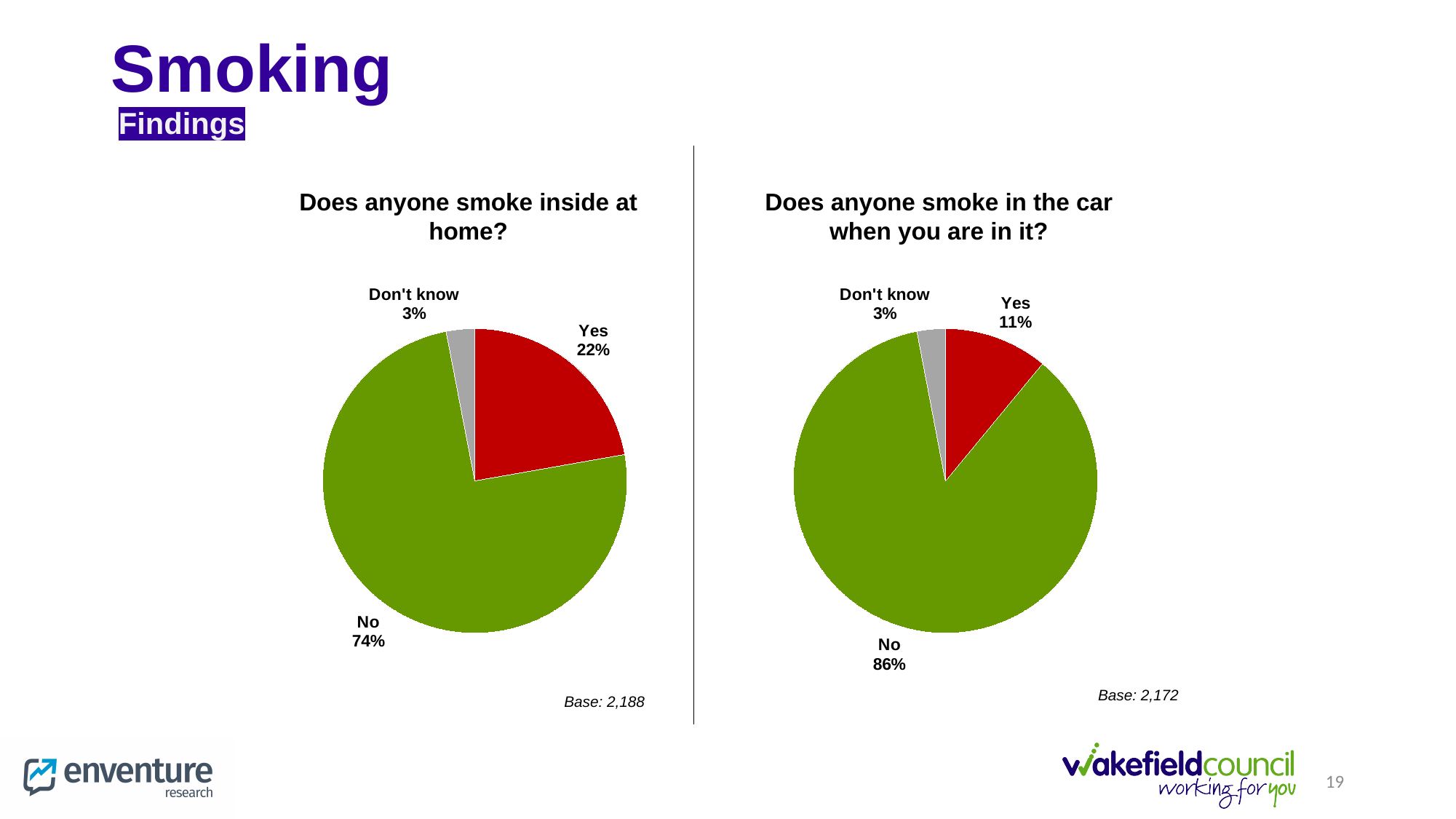
In the 'Does anyone smoke inside at home?' chart, what percentage answered Yes? 22% What type of chart is used for 'Does anyone smoke in the car when you are in it?'? Pie chart Which is larger: the No share in the 'Does anyone smoke inside at home?' chart or the No share in the 'Does anyone smoke in the car when you are in it?' chart? The No share in the 'Does anyone smoke in the car when you are in it?' chart In the 'Does anyone smoke inside at home?' chart, which response has the largest share? No In the 'Does anyone smoke in the car when you are in it?' chart, what percentage answered Don't know? 3% In the 'Does anyone smoke in the car when you are in it?' chart, what percentage answered No? 86% In the 'Does anyone smoke in the car when you are in it?' chart, what percentage answered Yes? 11% What is the base (number of respondents) shown for the 'Does anyone smoke inside at home?' chart? 2,188 How many slices does the 'Does anyone smoke inside at home?' pie chart have? 3 In the 'Does anyone smoke in the car when you are in it?' chart, which response has the smallest share? Don't know What is the difference in percentage points between the Yes share in the 'Does anyone smoke inside at home?' chart and the Yes share in the 'Does anyone smoke in the car when you are in it?' chart? 11 percentage points In the 'Does anyone smoke inside at home?' chart, what percentage answered No? 74%